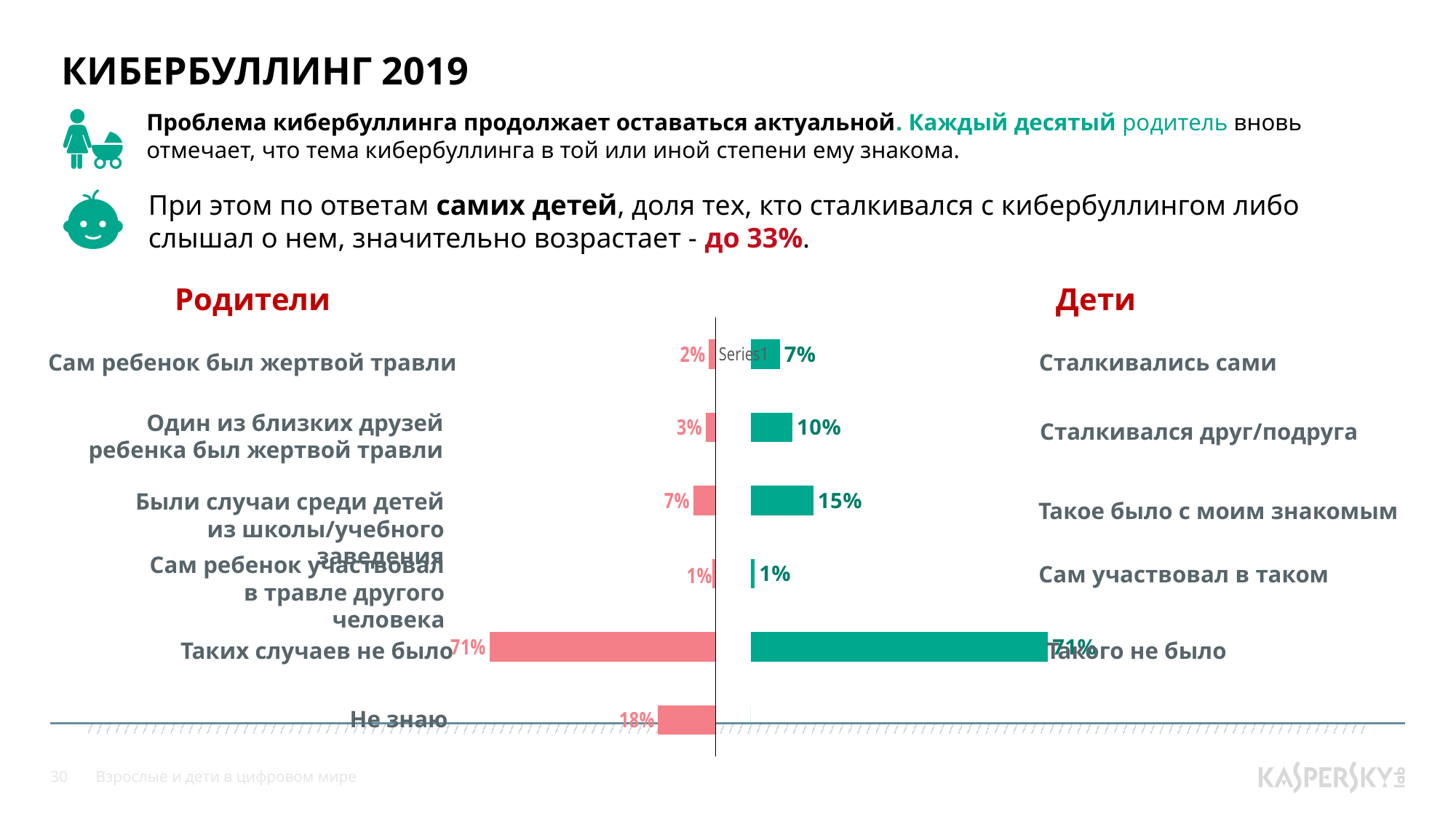
What type of chart is used on this slide? Bar chart In the Родители chart, which category has the highest value? Таких случаев не было In the Родители chart, what is the value for 'Не знаю'? 18% How many categories are shown in the Родители chart? 6 In the Родители chart, what percentage of parents said their own child was a victim of bullying (Сам ребенок был жертвой травли)? 2% In the Дети chart, what percentage of children said a friend had encountered cyberbullying (Сталкивался друг/подруга)? 10% Which is larger: the Дети value for 'Сталкивались сами' or the Родители value for 'Сам ребенок был жертвой травли'? Сталкивались сами (Дети) What colour are the bars in the Дети chart? Green What is the difference between the Дети value for 'Такое было с моим знакомым' (15%) and the Родители value for 'Были случаи среди детей из школы/учебного заведения' (7%)? 8% How many categories are shown in the Дети chart? 5 In the Дети chart, what is the value for 'Такое было с моим знакомым'? 15% In the Дети chart, which category has the lowest value? Сам участвовал в таком